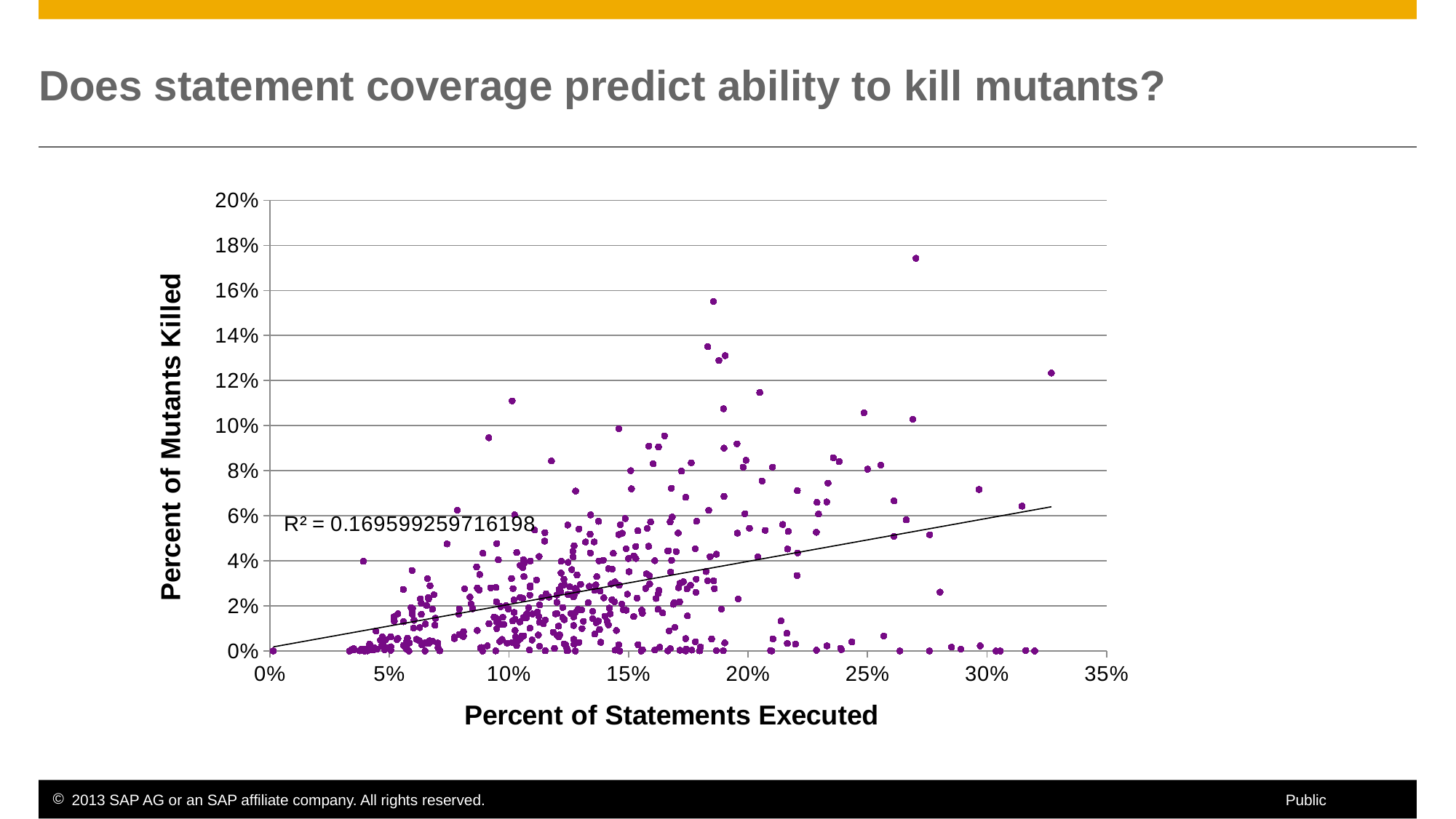
Is the value of the trend line at 0% statements executed greater or less than 2%? less Is the value of the trend line at 30% statements executed greater or less than 4%? greater What is the title of the x axis of the chart? Percent of Statements Executed Is the percent of mutants killed for the highest point on the chart greater or less than 16%? greater What is the title of the y axis of the chart? Percent of Mutants Killed What kind of chart is shown on the slide? scatter plot What R² value is printed on the chart? 0.169599259716198 Does the fitted trend line rise or fall as the percent of statements executed increases? rise